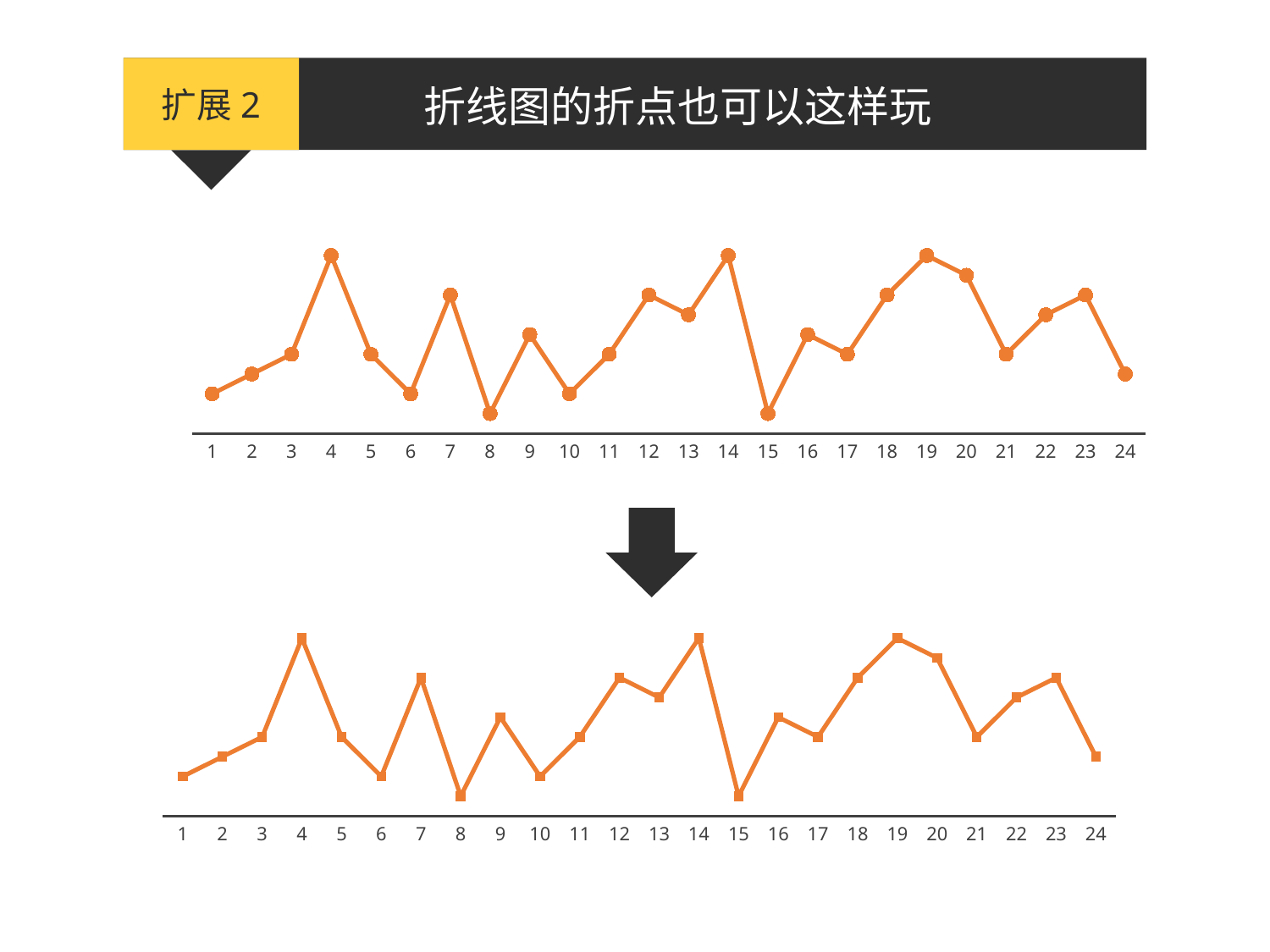
In the top chart, which is larger, the value at point 4 or the value at point 1? point 4 In the bottom chart, which is larger, the value at point 15 or the value at point 16? point 16 What marker shape is used for the data points in the top chart? circles What kind of chart is the top chart on the slide? line chart In the top chart, which is larger, the value at point 7 or the value at point 8? point 7 In the bottom chart, how many categories are labelled on the x axis? 24 In the top chart, how many points are plotted along the x axis? 24 In the bottom chart, do the values rise or fall from point 19 to point 21? fall What marker shape is used for the data points in the bottom chart? squares What kind of chart is the bottom chart on the slide? line chart In the top chart, do the values rise or fall from point 1 to point 4? rise